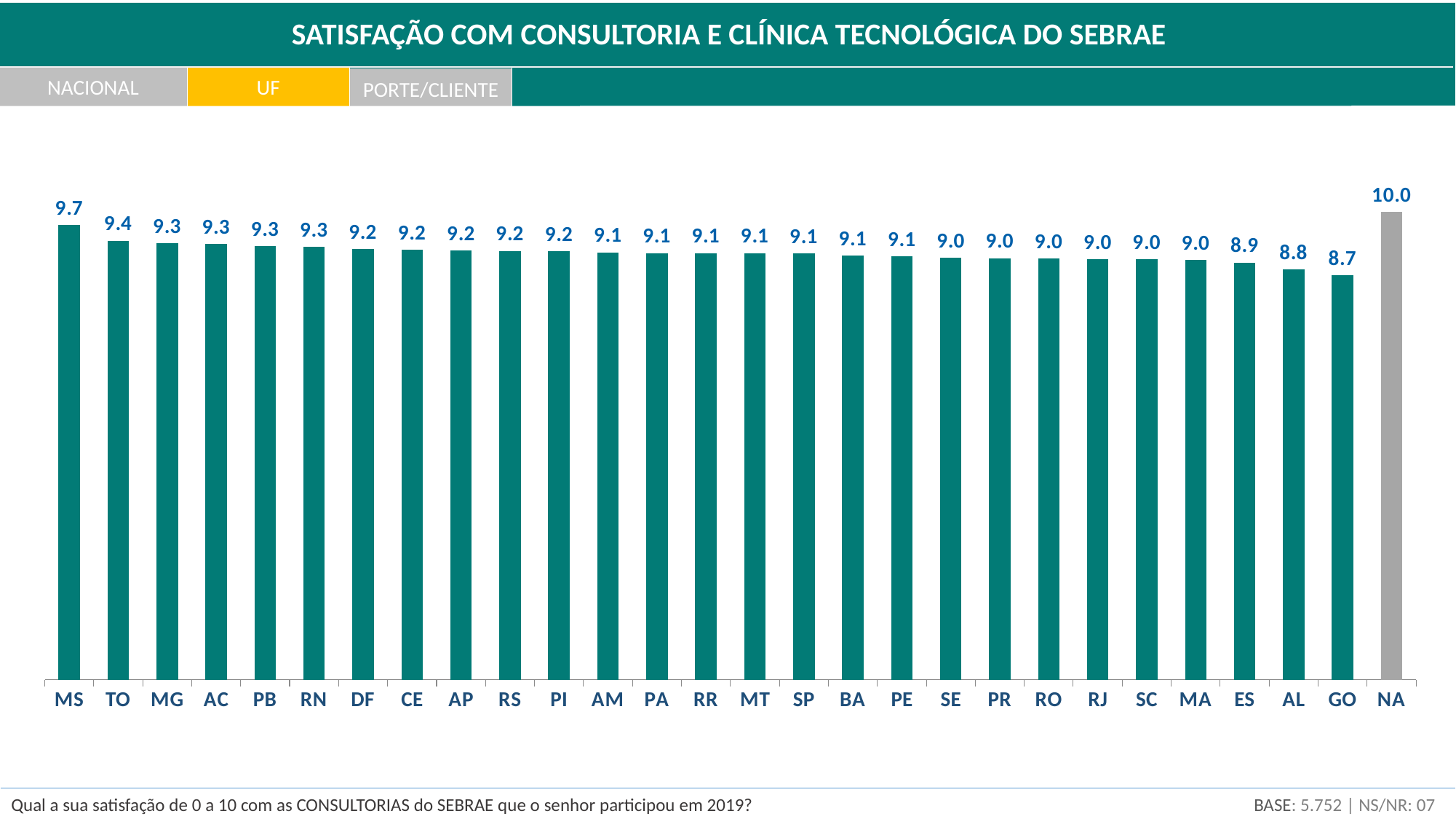
How many categories are shown on the x axis? 28 Which bar is coloured grey instead of teal? NA What is the value for ES? 8.9 What is the difference between the values for NA and AL? 1.2 Which category has the highest value? NA What is the value for MS? 9.7 What kind of chart is shown on the slide? bar chart Which is larger, the value for TO or the value for AL? TO Which category has the lowest value? GO What is the value for NA? 10.0 What is the value for GO? 8.7 What is the difference between the values for MS and GO? 1.0